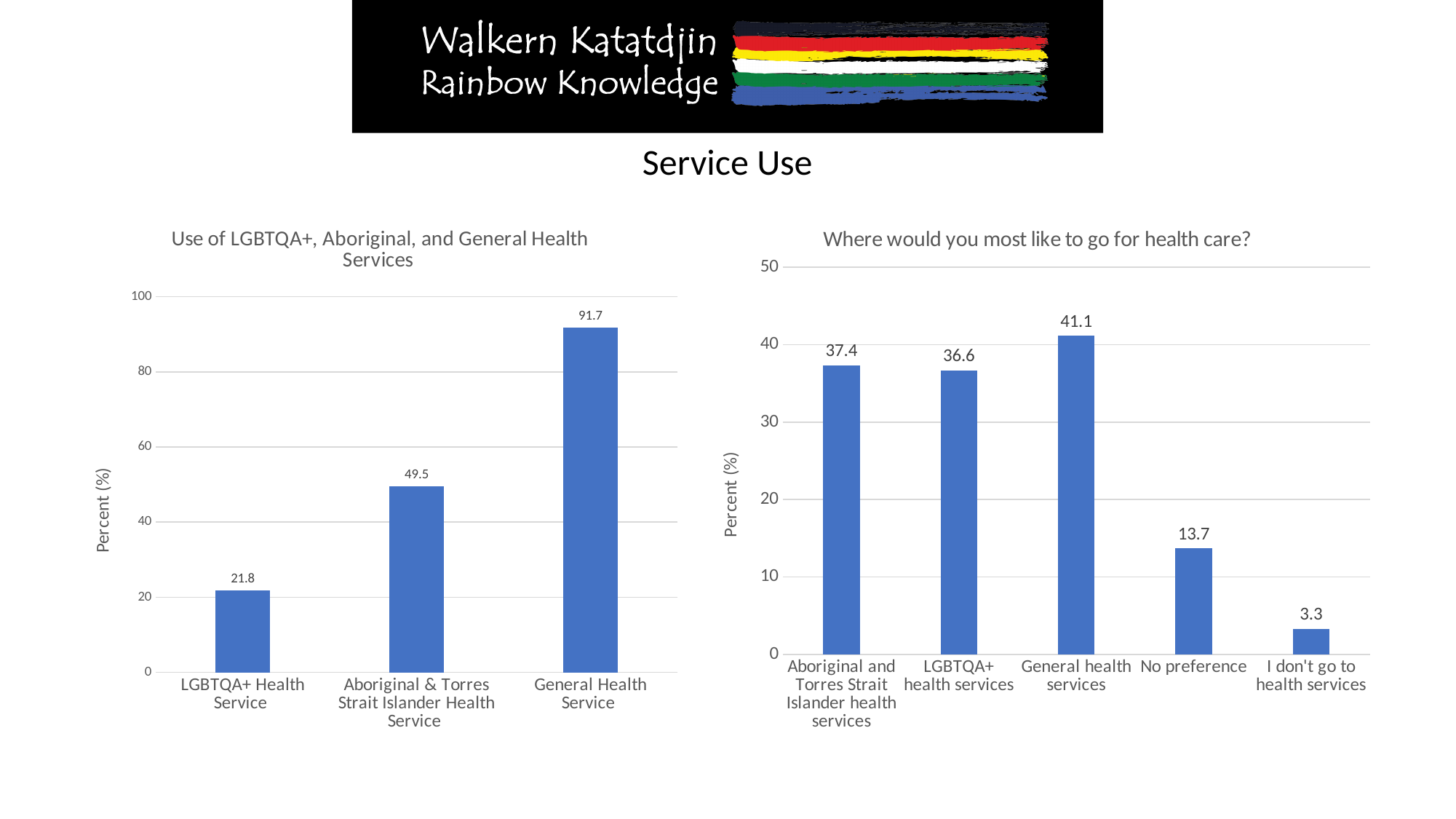
In the left chart 'Use of LGBTQA+, Aboriginal, and General Health Services', what is the value for LGBTQA+ Health Service? 21.8 What kind of chart is the right chart 'Where would you most like to go for health care?'? Bar chart In the left chart 'Use of LGBTQA+, Aboriginal, and General Health Services', how many categories are shown? 3 In the right chart 'Where would you most like to go for health care?', what is the value for No preference? 13.7 In the left chart 'Use of LGBTQA+, Aboriginal, and General Health Services', which category has the lowest value? LGBTQA+ Health Service In the left chart 'Use of LGBTQA+, Aboriginal, and General Health Services', what is the difference between General Health Service and Aboriginal & Torres Strait Islander Health Service? 42.2 In the right chart 'Where would you most like to go for health care?', how many categories are shown? 5 In the right chart 'Where would you most like to go for health care?', what is the value for I don't go to health services? 3.3 What is the y-axis label of the left chart 'Use of LGBTQA+, Aboriginal, and General Health Services'? Percent (%) In the right chart 'Where would you most like to go for health care?', which category has the highest value? General health services In the left chart 'Use of LGBTQA+, Aboriginal, and General Health Services', what is the value for General Health Service? 91.7 In the right chart 'Where would you most like to go for health care?', what is the difference between Aboriginal and Torres Strait Islander health services and LGBTQA+ health services? 0.8